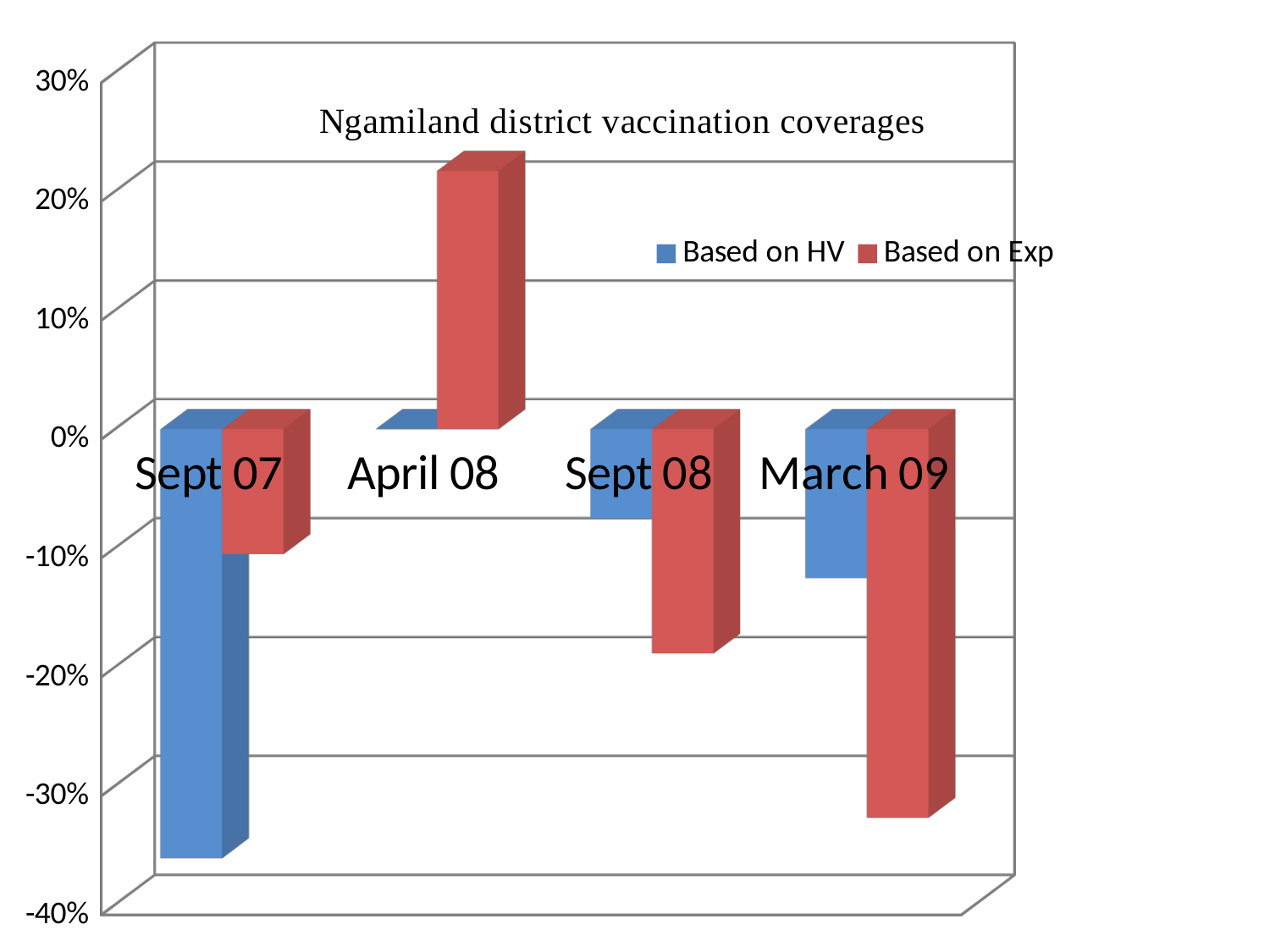
Which colour represents the 'Based on Exp' series? red For Sept 08, which series has the larger value, 'Based on HV' or 'Based on Exp'? Based on HV Which category has the lowest 'Based on Exp' value? March 09 Which category has the lowest 'Based on HV' value? Sept 07 What kind of chart is shown on the slide? bar chart How many categories are shown on the x axis? 4 Is the 'Based on Exp' value for March 09 greater or less than -20%? less Is the 'Based on HV' value for Sept 07 greater or less than -30%? less Is the 'Based on Exp' value for April 08 greater or less than 10%? greater Which category has the highest 'Based on Exp' value? April 08 How many series does the legend list? 2 What is the title of the chart? Ngamiland district vaccination coverages